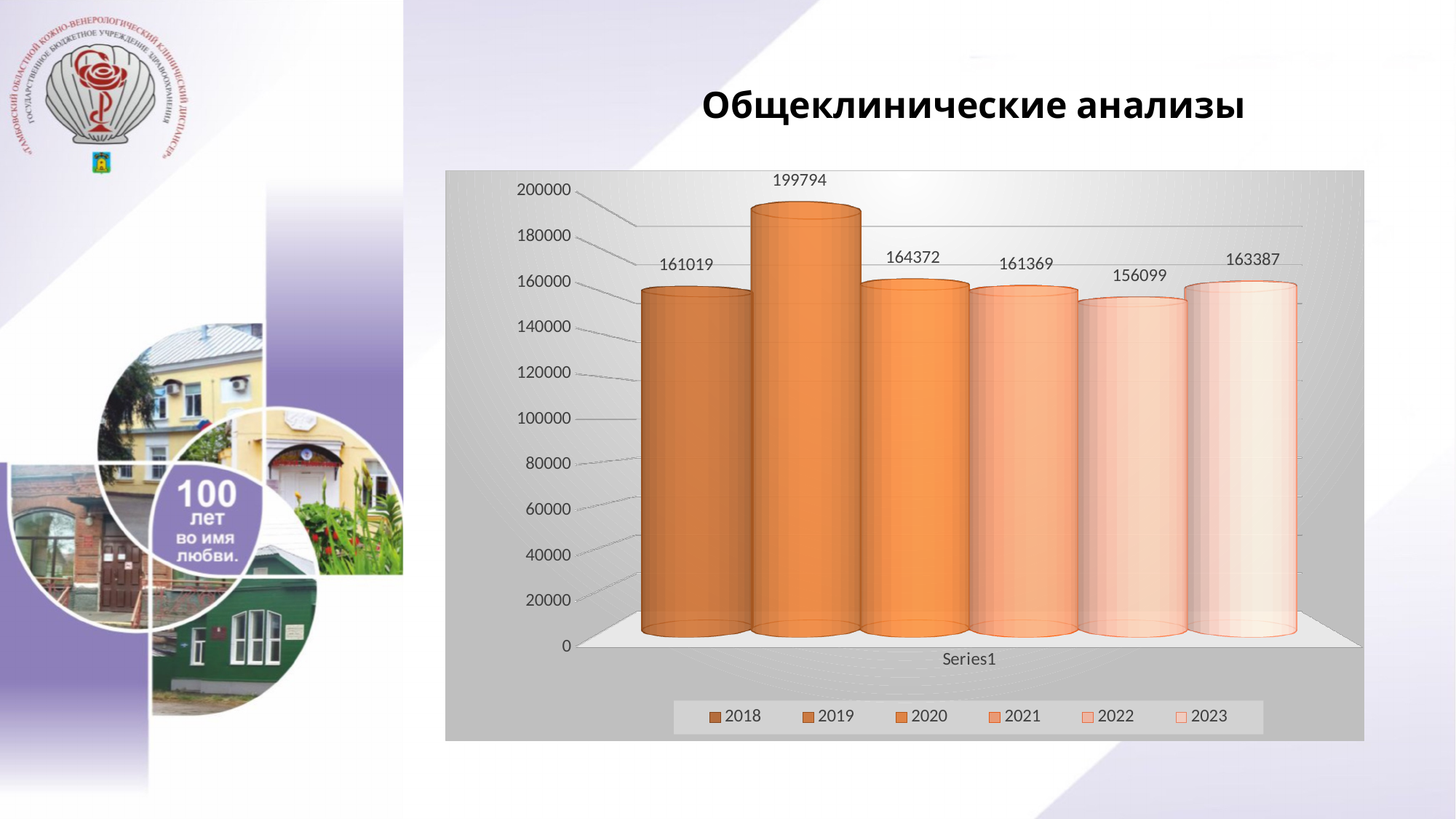
What is the title of the chart? Общеклинические анализы Which year has the highest value? 2019 What is the difference between the values for 2020 and 2021? 3003 How many series does the legend list? 6 What is the value for 2023? 163387 What is the value for 2018? 161019 What is the value for 2022? 156099 What kind of chart is shown on the slide? Bar chart Which year has the lowest value? 2022 Which is larger, the value for 2020 or the value for 2022? 2020 What is the difference between the values for 2019 and 2018? 38775 What is the value for 2019? 199794